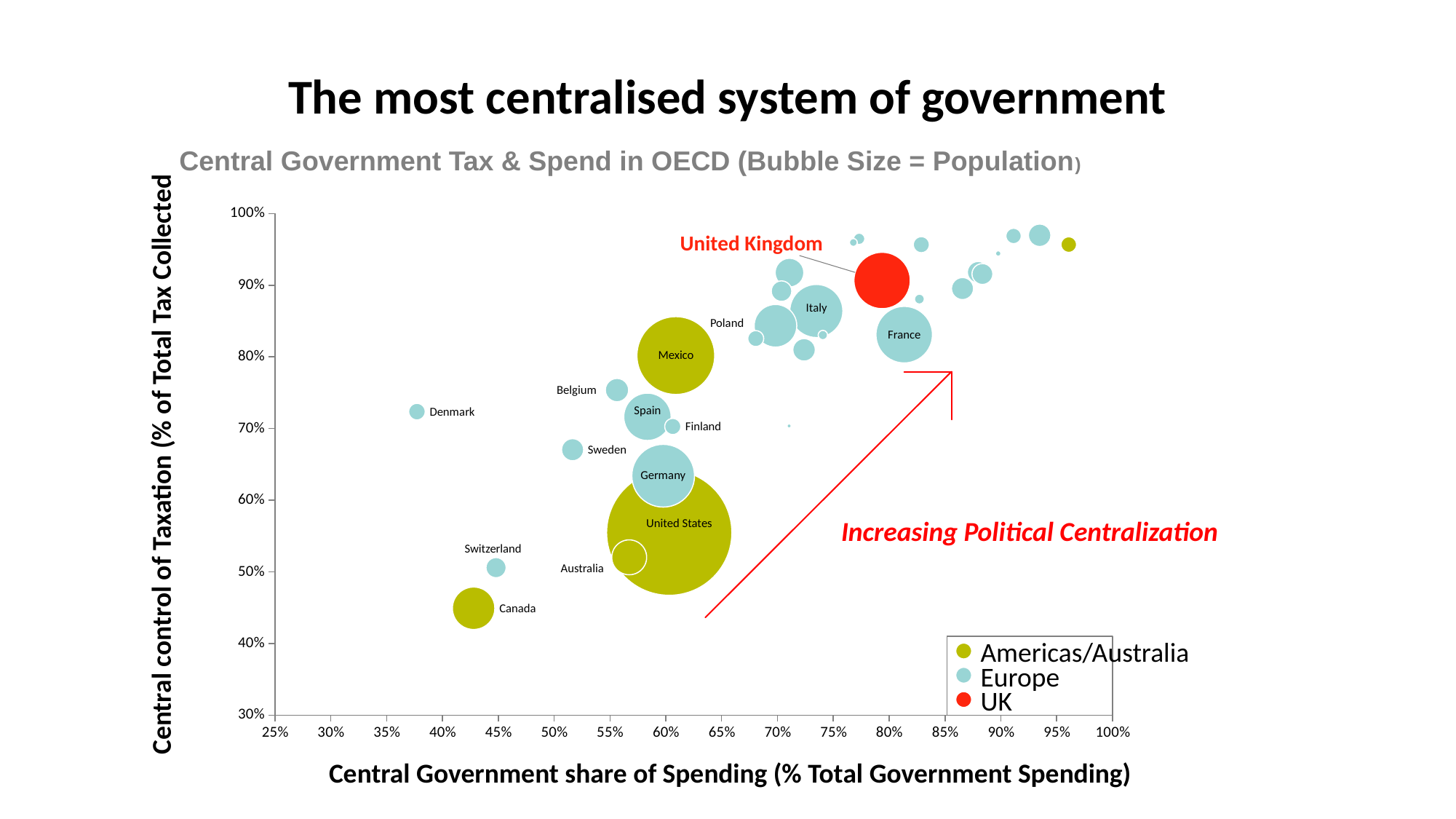
Which colour is used for the UK bubble in the chart? Red Is the Central Government share of Spending for Switzerland greater or less than 50%? less Which has a higher Central control of Taxation value, the United Kingdom or France? United Kingdom How many series does the legend list? 3 Is the Central control of Taxation value for Sweden greater or less than 70%? less Is the Central Government share of Spending for France greater or less than 75%? greater What kind of chart is shown on the slide? Bubble chart Which has a higher Central Government share of Spending, Canada or Mexico? Mexico Which has a higher Central control of Taxation value, Denmark or Sweden? Denmark What does the bubble size represent in the chart? Population